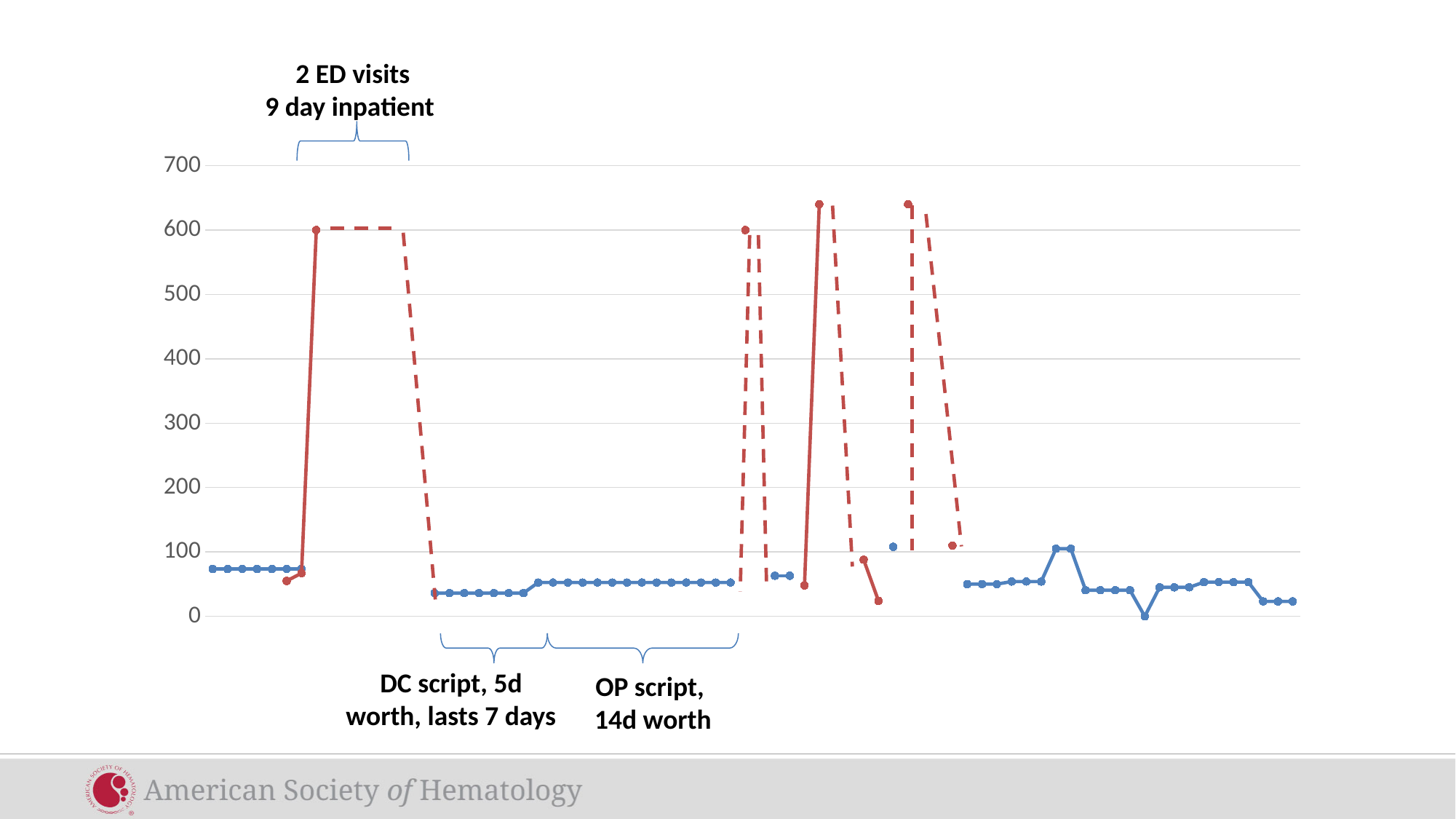
Is the value of the red line's plateau during the '2 ED visits / 9 day inpatient' period greater or less than 500? greater Which is higher: the blue line during the 'DC script' period or the blue line during the 'OP script' period? OP script period What annotation is written above the bracket at the top of the chart? 2 ED visits 9 day inpatient What kind of chart is shown on the slide? line chart Is the value of the blue line during the 'OP script, 14d worth' period greater or less than 100? less Is the value of the blue line during the 'DC script, 5d worth, lasts 7 days' period greater or less than 100? less What is the highest value shown on the y axis? 700